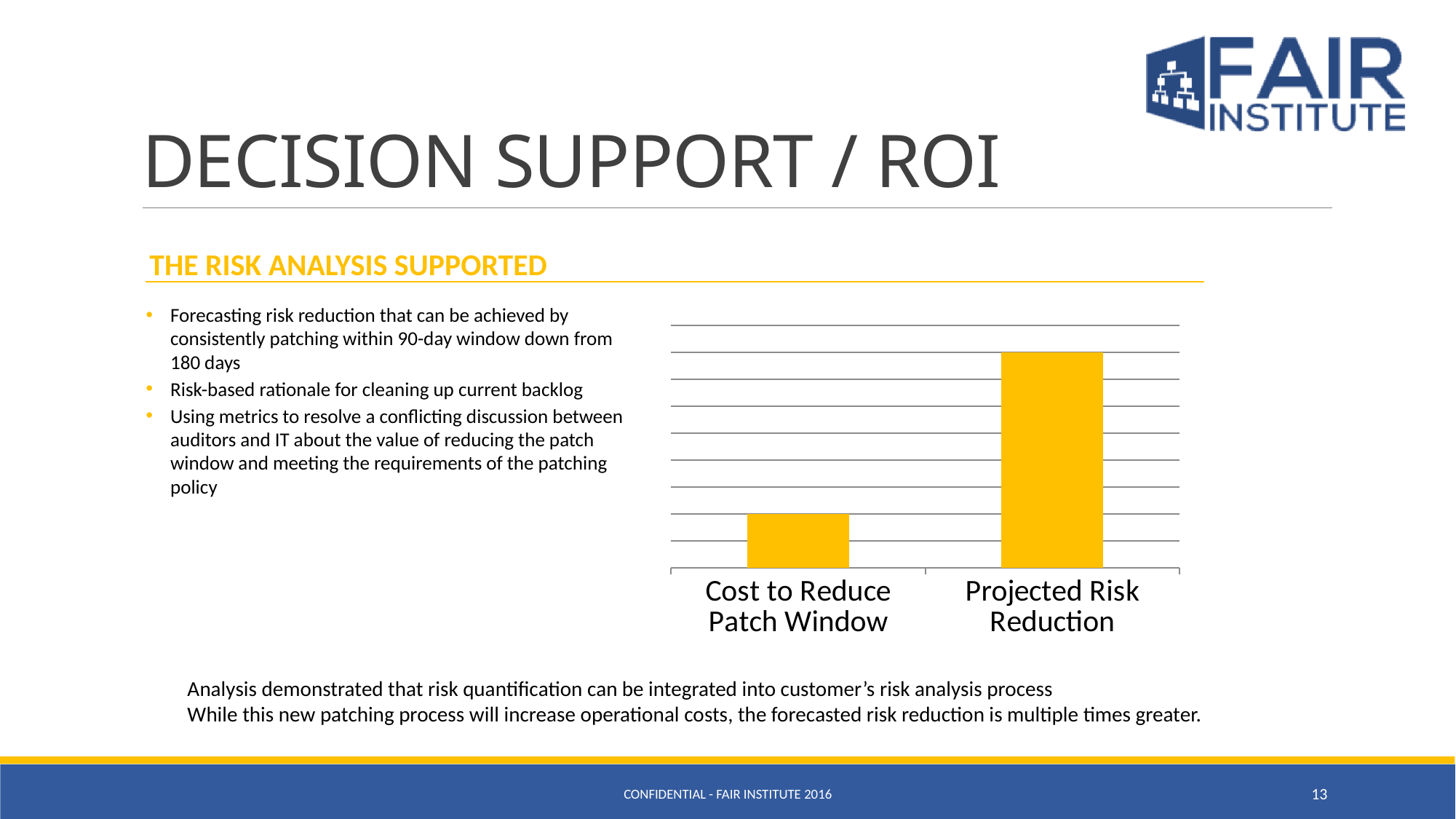
What kind of chart is shown on the slide? bar chart What colour are the bars in the chart? yellow How many categories does the chart show? 2 Do the bar values rise or fall from left to right across the chart? rise Which category has the highest bar in the chart? Projected Risk Reduction Which is larger in the chart, Cost to Reduce Patch Window or Projected Risk Reduction? Projected Risk Reduction Which category has the lowest bar in the chart? Cost to Reduce Patch Window What is the label of the left-hand category in the chart? Cost to Reduce Patch Window